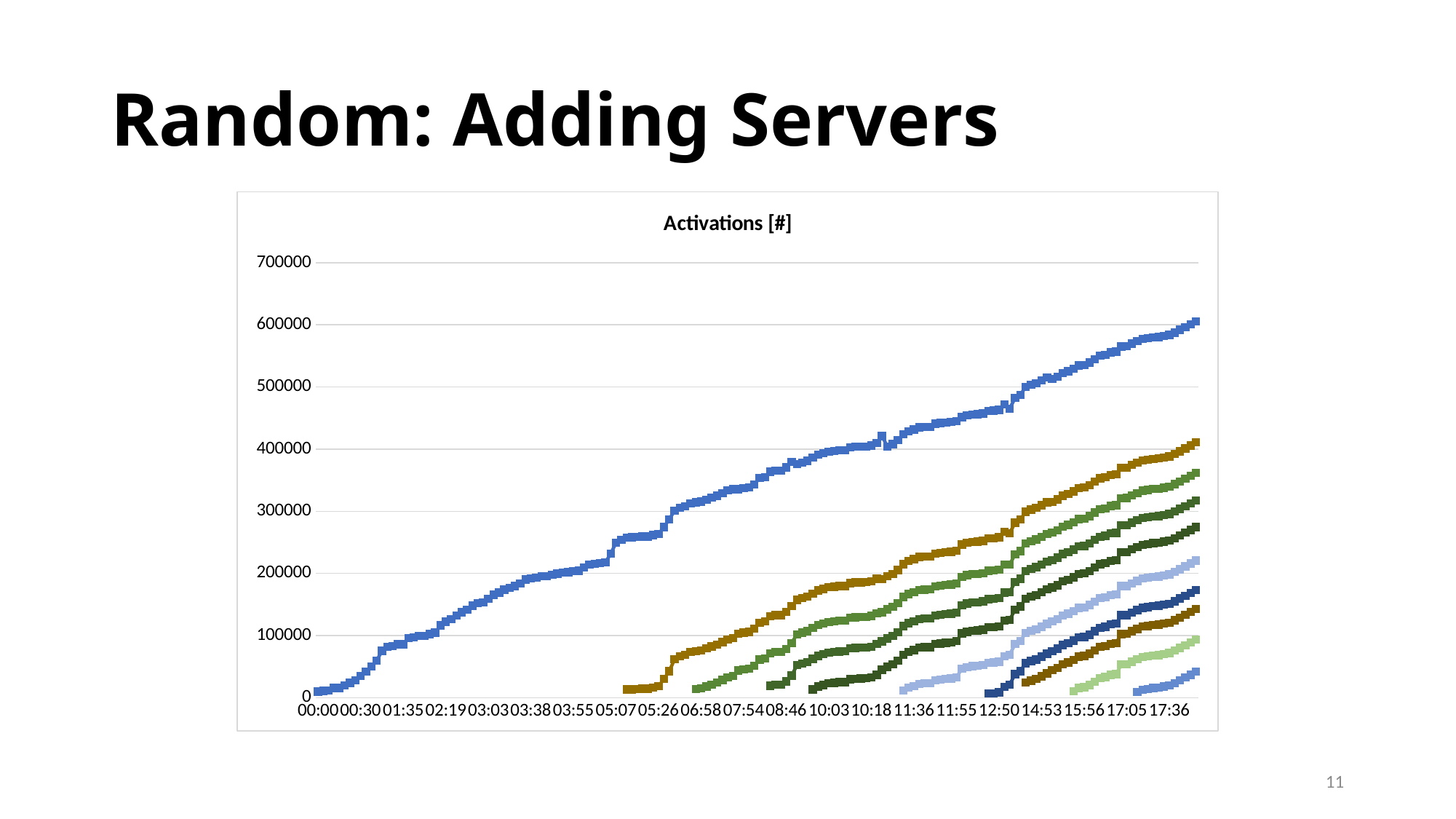
What is the title of the chart? Activations [#] Is the value of the topmost line at 05:07 greater or less than 300000? less What is the highest value shown on the y axis? 700000 What kind of chart is shown on the slide? line chart Is the final value of the lowest line greater or less than 100000? less Is the final value of the second-highest (gold) line greater or less than 300000? greater Do the plotted lines rise or fall along the x axis? rise Which line reaches the highest value at the right edge of the chart? the blue line How many time labels are shown on the x axis? 21 What is the first time label on the x axis? 00:00 What is the last time label on the x axis? 17:36